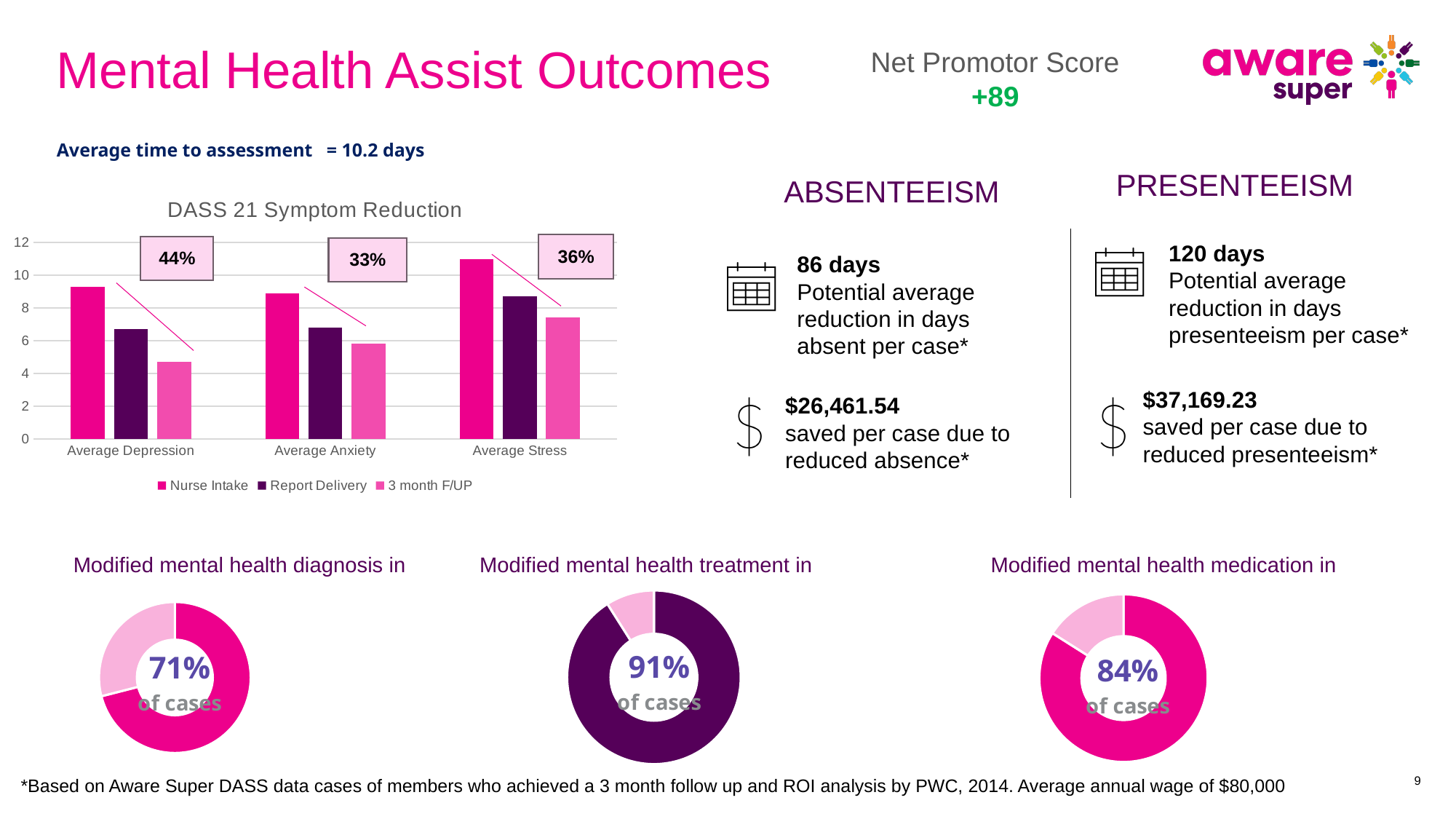
In the DASS 21 Symptom Reduction chart, which is larger for Average Anxiety: Nurse Intake or Report Delivery? Nurse Intake In the DASS 21 Symptom Reduction chart, is the 3 month F/UP value for Average Depression greater or less than 6? less In the 'Modified mental health treatment in' donut chart, what share of cases is shown? 91% How many series does the legend of the DASS 21 Symptom Reduction chart list? 3 What kind of chart is the DASS 21 Symptom Reduction chart? bar chart In the 'Modified mental health medication in' donut chart, what share of cases is shown? 84% In the DASS 21 Symptom Reduction chart, what percentage reduction is labelled above the Average Stress bars? 36% How many categories are shown on the x axis of the DASS 21 Symptom Reduction chart? 3 In the DASS 21 Symptom Reduction chart, which category has the lowest 3 month F/UP value? Average Depression In the DASS 21 Symptom Reduction chart, which category has the highest Nurse Intake value? Average Stress In the DASS 21 Symptom Reduction chart, is the Nurse Intake value for Average Stress greater or less than 10? greater In the DASS 21 Symptom Reduction chart, what percentage reduction is labelled above the Average Depression bars? 44%